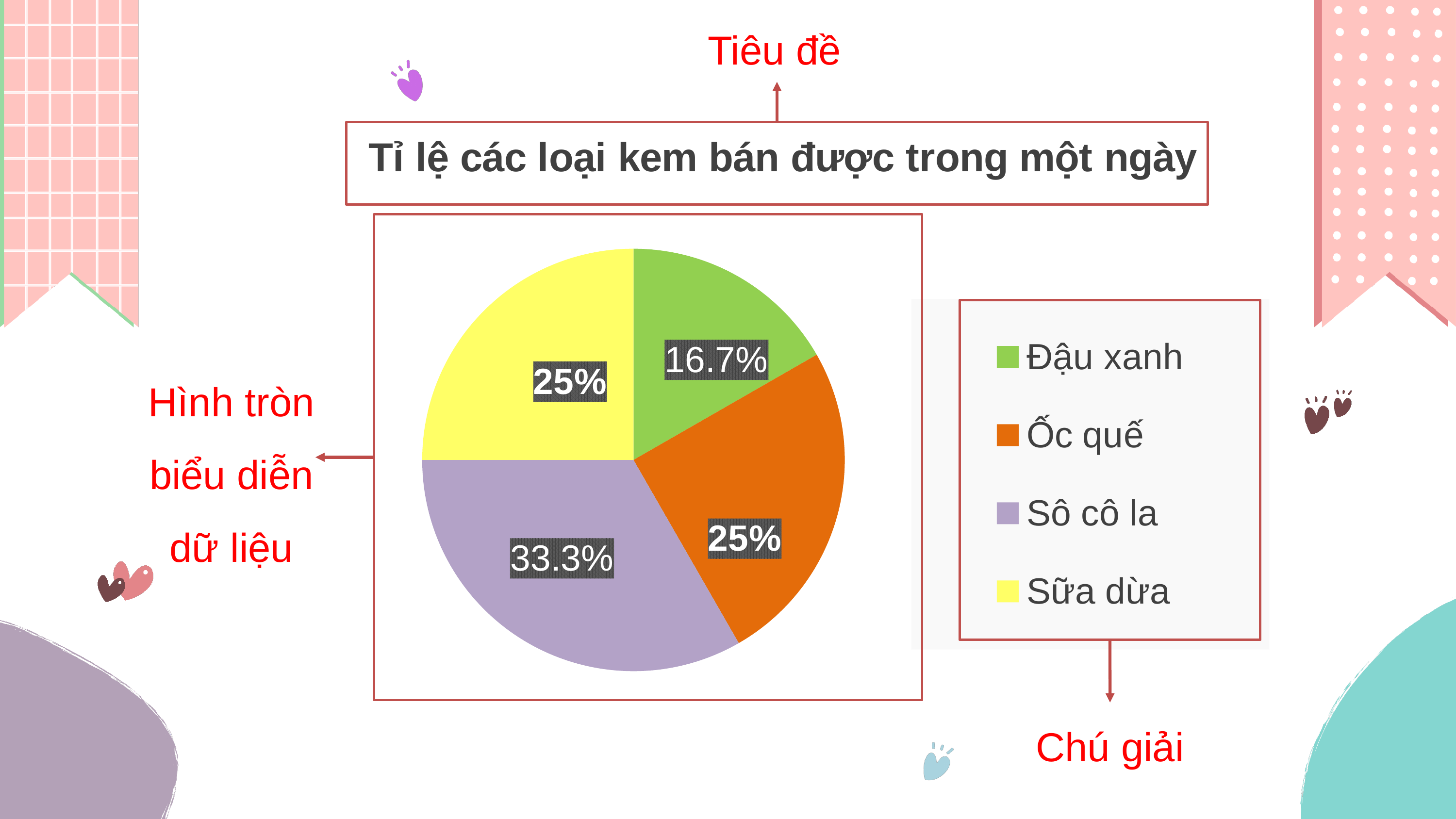
Which ice cream type has the smallest share of the pie? Đậu xanh Which is larger, the share for Sô cô la or the share for Ốc quế? Sô cô la What percentage of the pie does Sô cô la represent? 33.3% What is the difference in percentage points between Sô cô la and Đậu xanh? 16.6 What type of chart is shown on the slide? Pie chart What percentage of the pie does Sữa dừa represent? 25% What percentage of the pie does Ốc quế represent? 25% What percentage of the pie does Đậu xanh represent? 16.7% Which ice cream type has the largest share of the pie? Sô cô la What is the title of the chart? Tỉ lệ các loại kem bán được trong một ngày Which colour represents Sữa dừa in the legend? Yellow How many categories does the pie chart show? 4